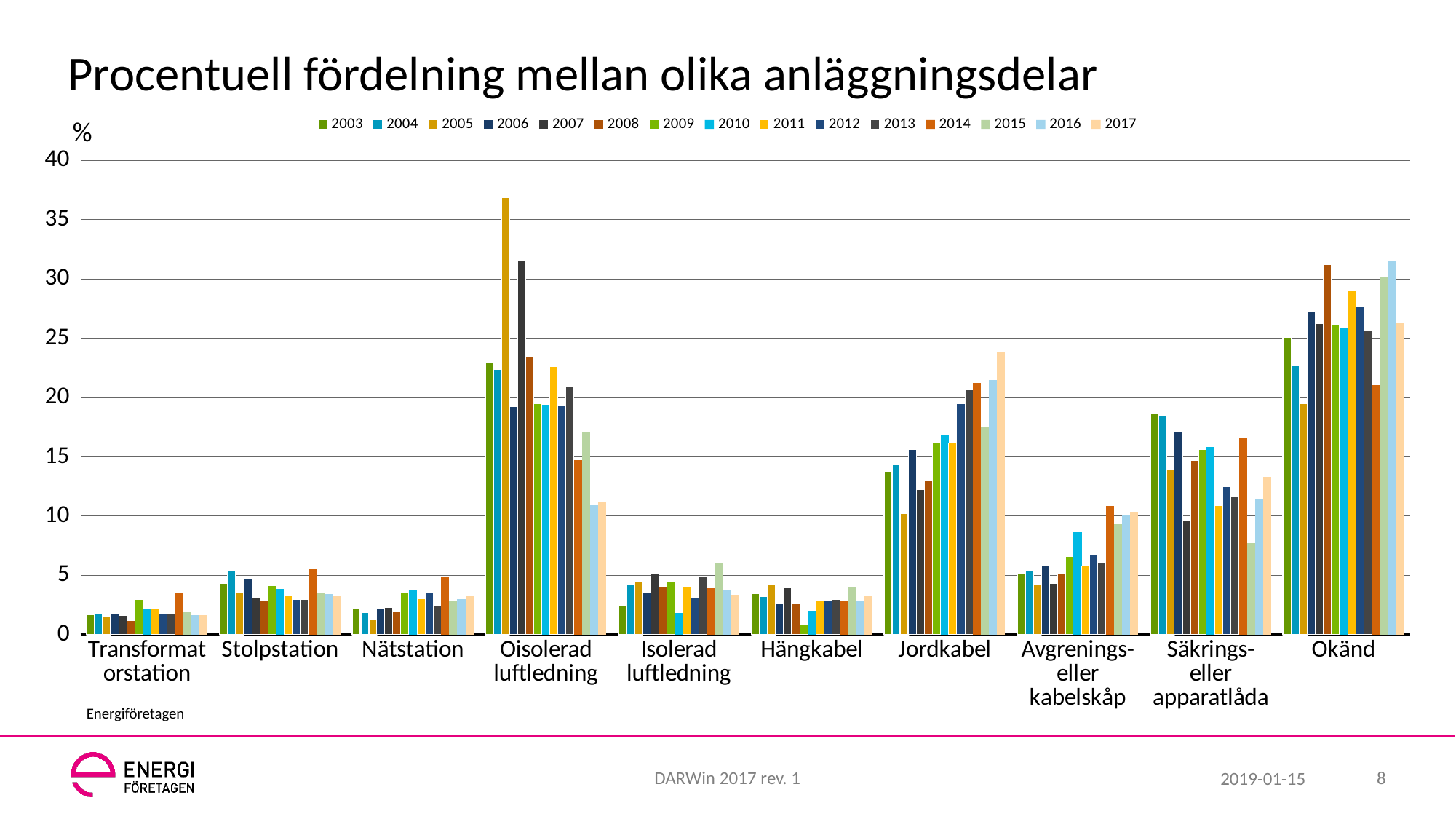
Is the value for Hängkabel in 2009 greater or less than 5? less Which category has the highest value for 2005? Oisolerad luftledning Do the values for Jordkabel generally rise or fall from 2003 to 2017? rise Is the value for Oisolerad luftledning in 2005 greater or less than 35? greater Is the value for Okänd in 2014 greater or less than 30? less Which is larger in 2017: Jordkabel or Oisolerad luftledning? Jordkabel What is the title of the chart? Procentuell fördelning mellan olika anläggningsdelar How many categories are shown on the x axis? 10 Which category has the highest value for 2017? Okänd How many series does the legend list? 15 What kind of chart is shown on the slide? Bar chart